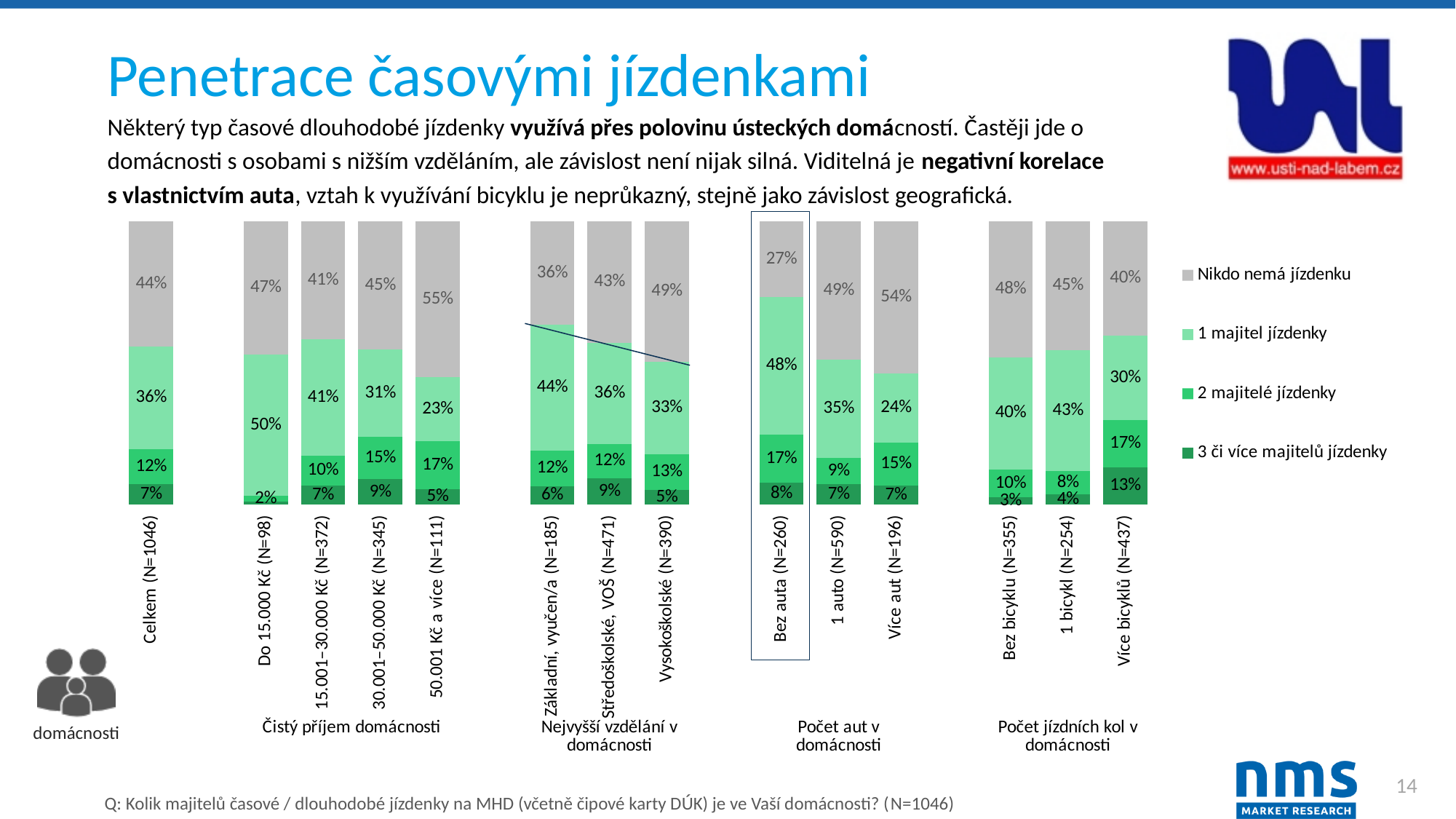
Which legend entry is shown in grey? Nikdo nemá jízdenku Which category has the lowest value for 'Nikdo nemá jízdenku'? Bez auta (N=260) How many bars (categories) are plotted in the chart? 14 What kind of chart is shown on the slide? stacked bar chart Which category has the highest value for 'Nikdo nemá jízdenku'? 50.001 Kč a více (N=111) What is the value of '3 či více majitelů jízdenky' for Více bicyklů (N=437)? 13% Which is larger: the '1 majitel jízdenky' value for Základní, vyučen/a (N=185) or for Vysokoškolské (N=390)? Základní, vyučen/a (N=185) How many series does the legend list? 4 What is the value of '1 majitel jízdenky' for Bez auta (N=260)? 48% What is the value of 'Nikdo nemá jízdenku' for Celkem (N=1046)? 44% What is the difference between the 'Nikdo nemá jízdenku' values for Více aut (N=196) and Bez auta (N=260)? 27% What is the total of the '2 majitelé jízdenky' and '3 či více majitelů jízdenky' segments for Celkem (N=1046)? 19%